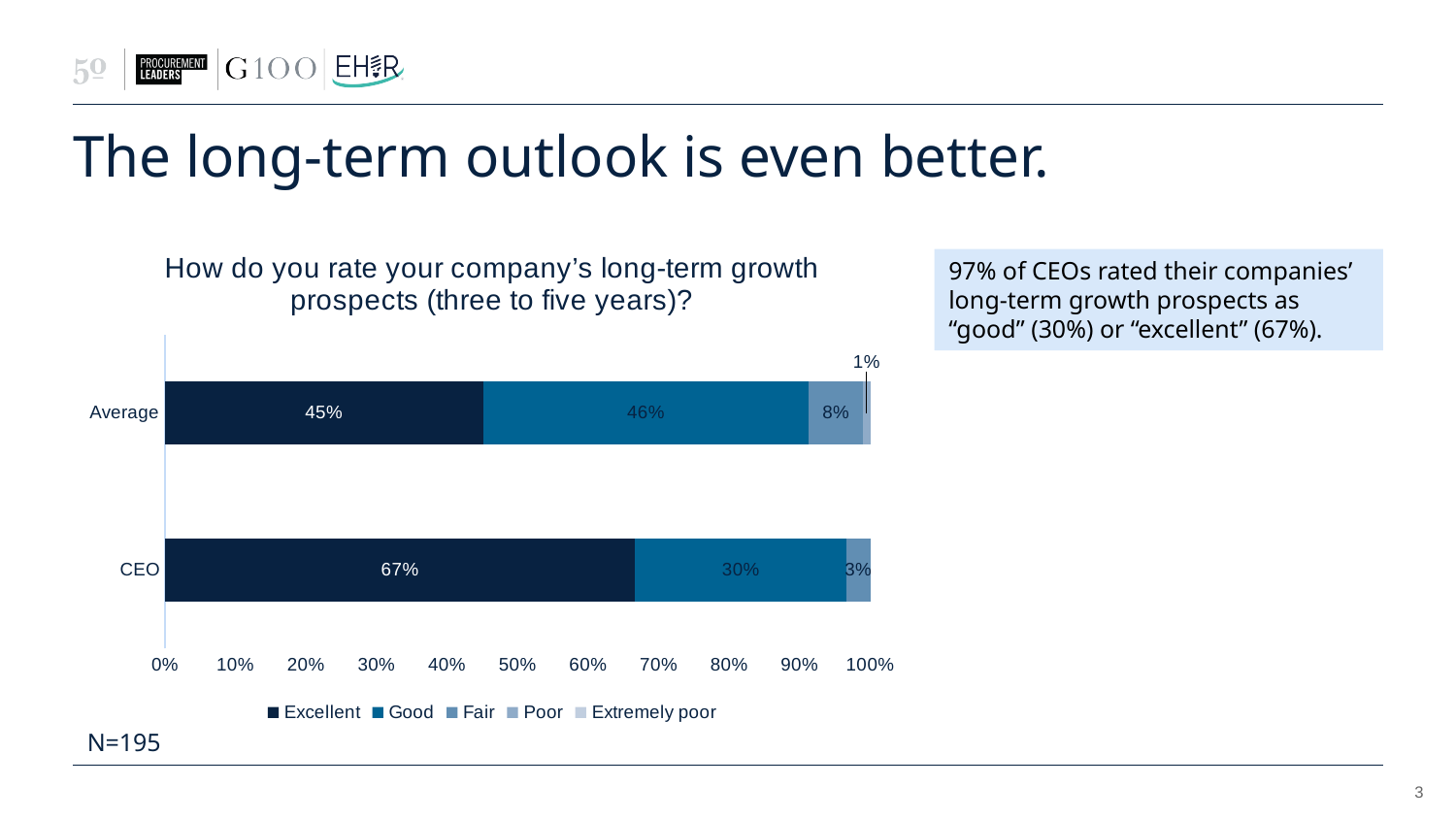
What is the Fair value for the Average bar? 8% How many series does the legend list? 5 What is the combined share of Excellent and Good for the CEO bar? 97% What is the difference between the Excellent share for CEO and for Average? 22 percentage points What is the Good value for the Average bar? 46% Which group has the larger Excellent share, CEO or Average? CEO What kind of chart is shown on the slide? Stacked bar chart What is the Excellent value for the Average bar? 45% What percentage of CEOs rated their long-term growth prospects as Excellent? 67% What is the title of the chart? How do you rate your company's long-term growth prospects (three to five years)? What is the Good value for the CEO bar? 30% How many categories (bars) does the chart show? 2